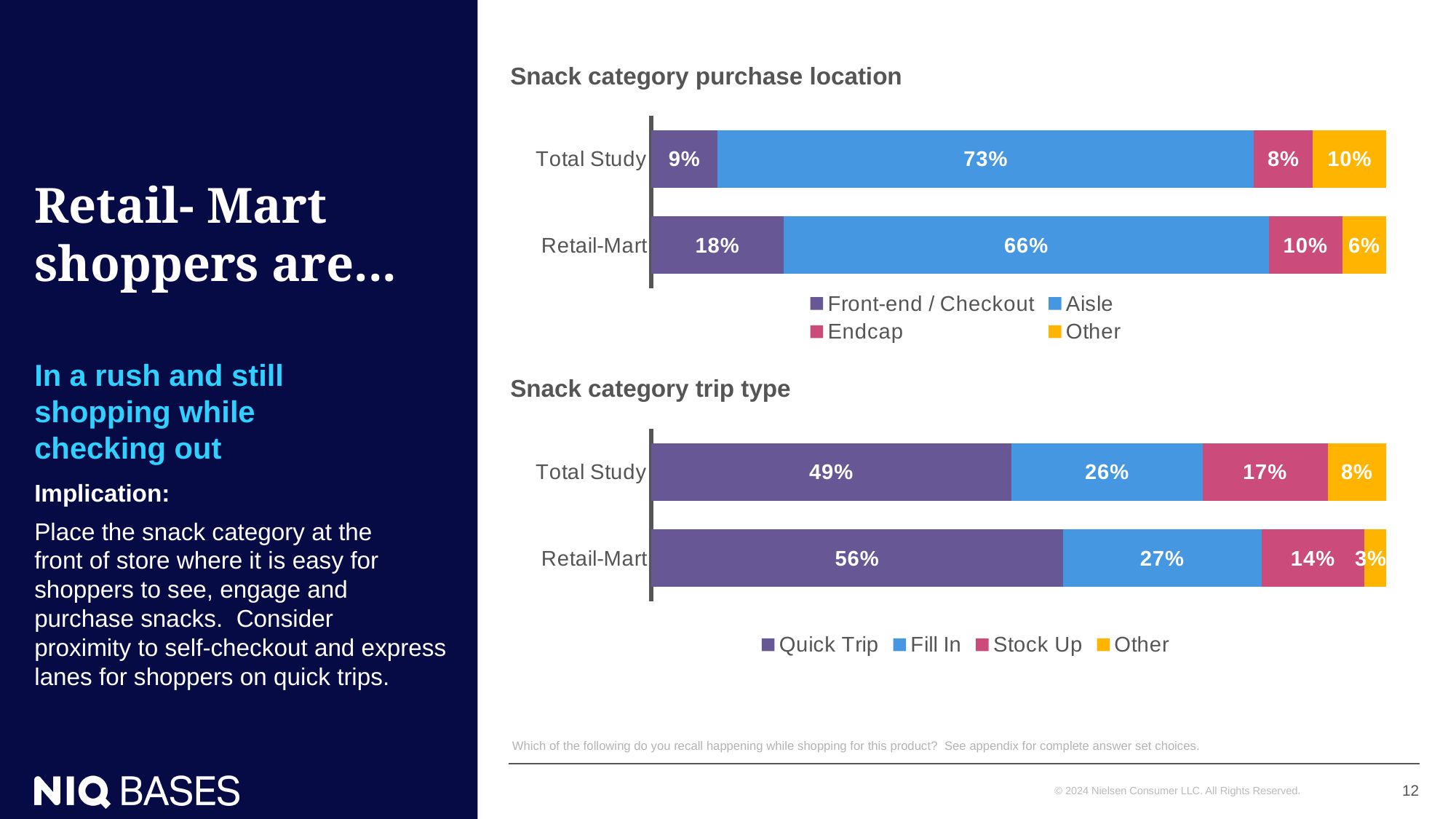
In the 'Snack category trip type' chart, what is the Stock Up value for Total Study? 17% In the 'Snack category purchase location' chart, what is the difference between the Front-end / Checkout values for Retail-Mart and Total Study? 9% In the 'Snack category purchase location' chart, what is the Aisle value for Retail-Mart? 66% In the 'Snack category trip type' chart, which segment is the smallest for Retail-Mart? Other In the 'Snack category purchase location' chart, which has the larger Endcap value, Total Study or Retail-Mart? Retail-Mart In the 'Snack category trip type' chart, which segment is the largest for Total Study? Quick Trip In the 'Snack category purchase location' chart, what is the Front-end / Checkout value for Total Study? 9% In the 'Snack category trip type' chart, what is the difference between the Other values for Total Study and Retail-Mart? 5% In the 'Snack category purchase location' chart, how many series does the legend list? 4 In the 'Snack category trip type' chart, what is the Quick Trip value for Retail-Mart? 56% What kind of chart is the 'Snack category trip type' chart? Stacked bar chart In the 'Snack category trip type' chart, what is the total of the Retail-Mart bar? 100%